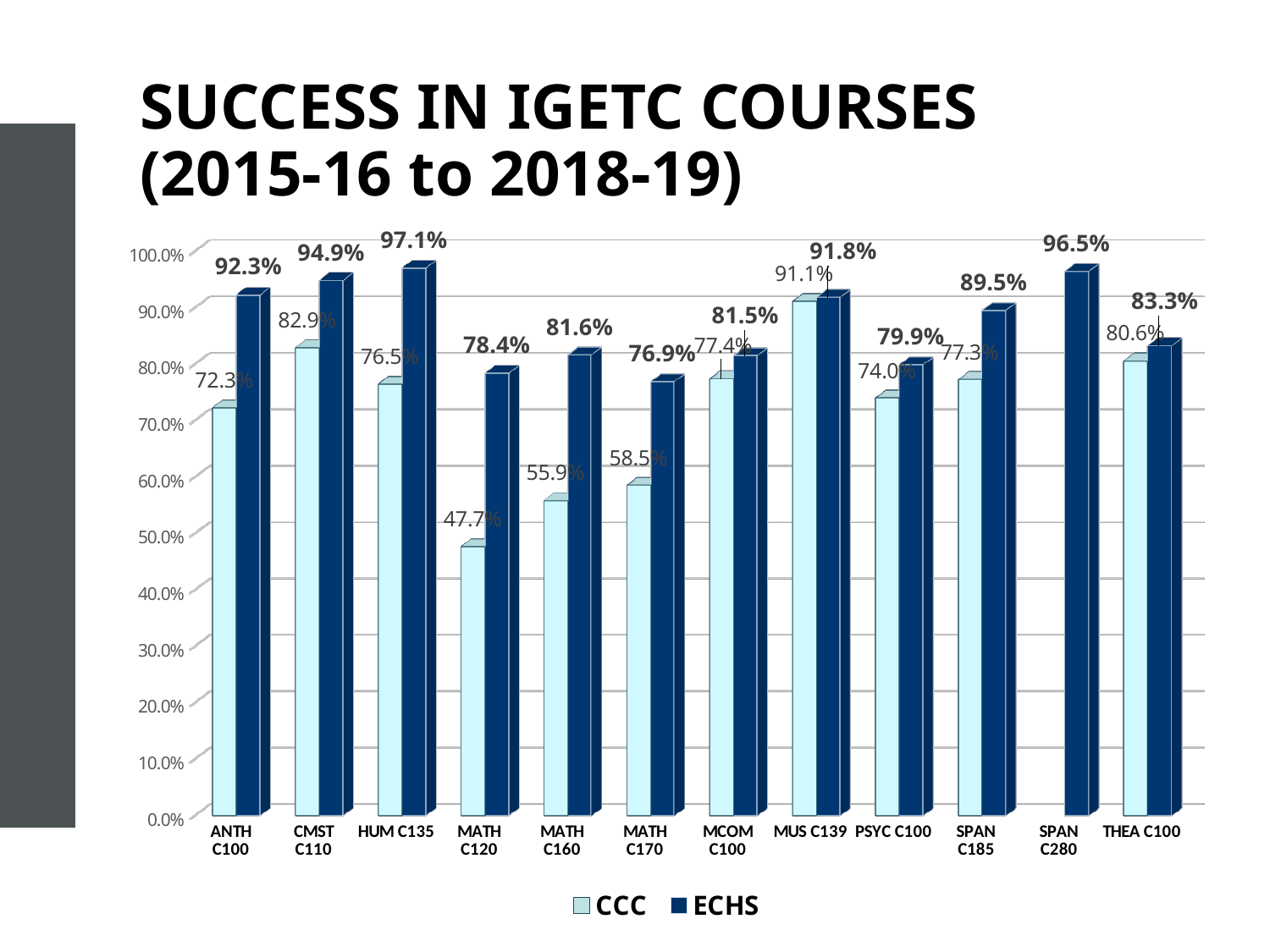
Which course has the highest ECHS success rate? HUM C135 What is the ECHS success rate for HUM C135? 97.1% What type of chart is shown on the slide? Bar chart What is the ECHS success rate for SPAN C280? 96.5% Is the CCC success rate for MATH C160 greater or less than 60.0%? less How many courses are shown on the x axis? 12 What is the CCC success rate for MATH C120? 47.7% Which course has the lowest CCC success rate? MATH C120 How many series does the legend list? 2 Which is larger for CMST C110, the CCC rate or the ECHS rate? ECHS What is the CCC success rate for MUS C139? 91.1% What is the difference between the ECHS and CCC success rates for ANTH C100? 20.0 percentage points